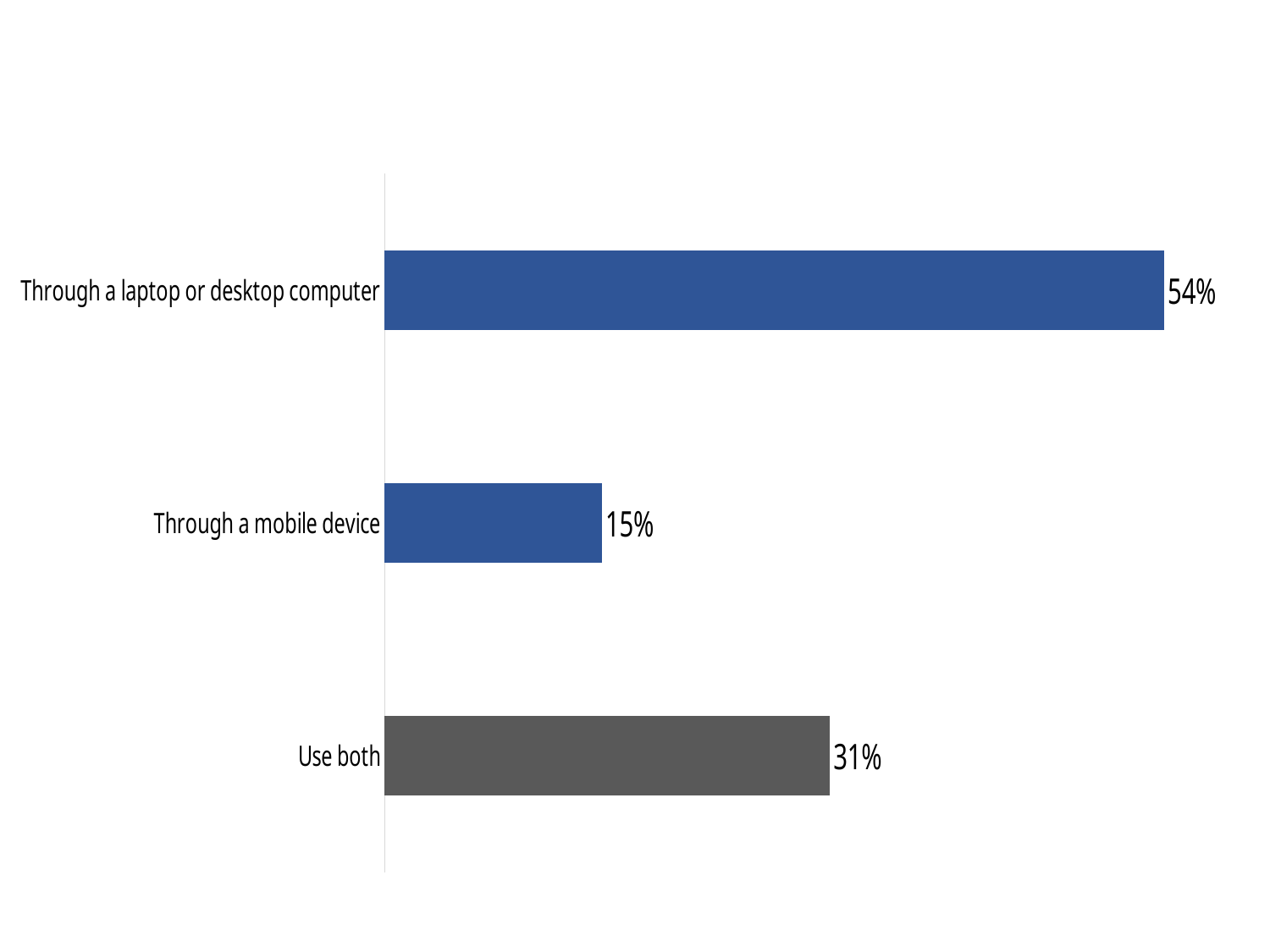
What is the value for "Through a mobile device"? 15% What is the value for "Use both"? 31% What is the value for "Through a laptop or desktop computer"? 54% How many categories are shown in the chart? 3 What kind of chart is shown on the slide? Bar chart Which category's bar is coloured grey rather than blue? Use both Which category has the highest value? Through a laptop or desktop computer Which is larger, the value for "Use both" or the value for "Through a mobile device"? Use both Which category has the lowest value? Through a mobile device What is the total of the three values shown in the chart? 100% What is the difference between the values for "Through a laptop or desktop computer" and "Through a mobile device"? 39% What is the difference between the values for "Use both" and "Through a mobile device"? 16%